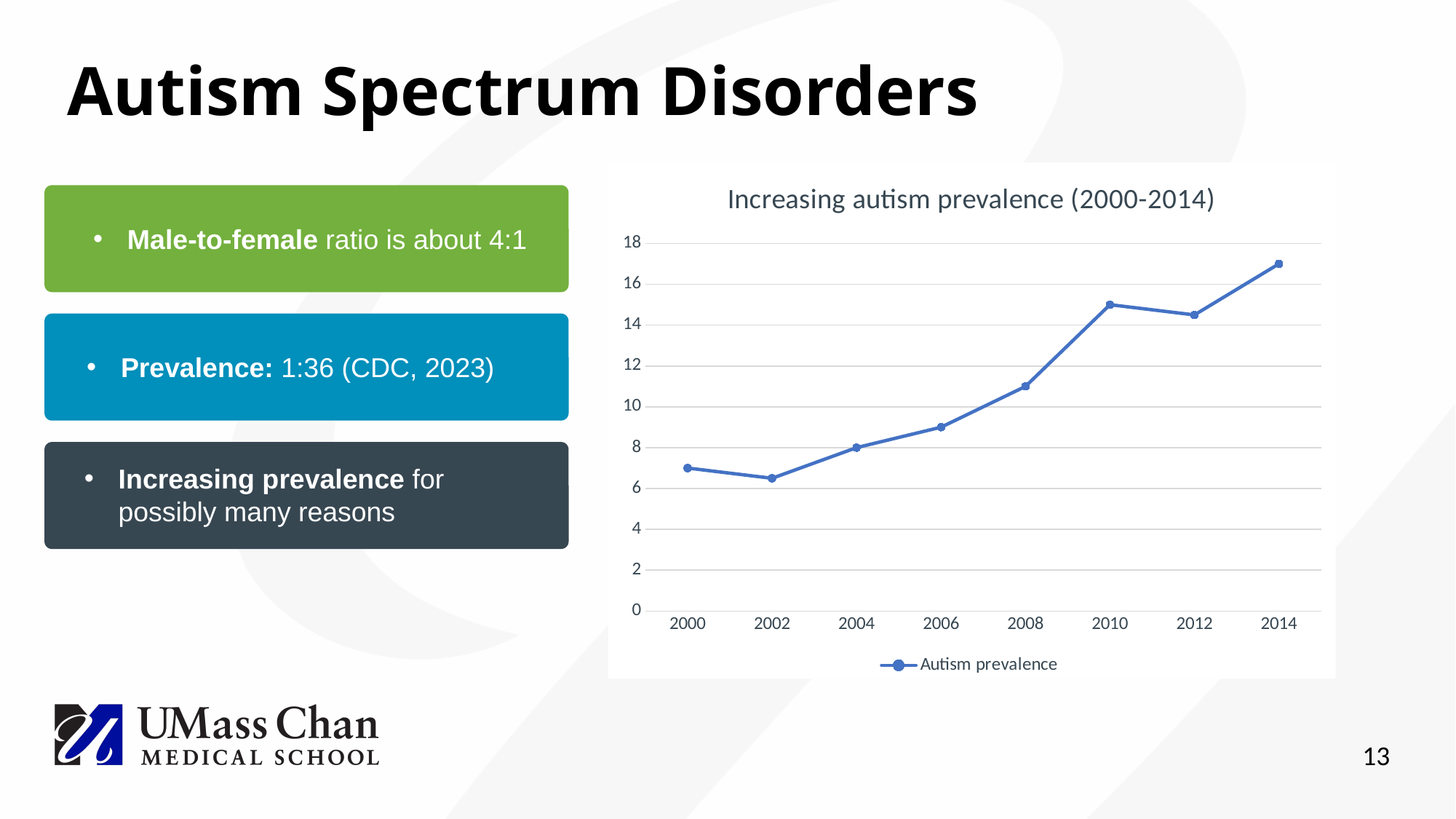
What type of chart is shown on the slide? line chart What is the title of the chart? Increasing autism prevalence (2000-2014) Does the autism prevalence generally rise or fall from 2000 to 2014? rise Is the autism prevalence value for 2008 greater or less than 12? less Is the autism prevalence value for 2014 greater or less than 16? greater Which year has the highest autism prevalence value? 2014 How many data points are plotted on the line? 8 How many series does the chart legend list? 1 Which year has a higher autism prevalence value, 2006 or 2008? 2008 What is the name of the series shown in the chart legend? Autism prevalence What is the autism prevalence value for 2004? 8 Which year has the lowest autism prevalence value? 2002